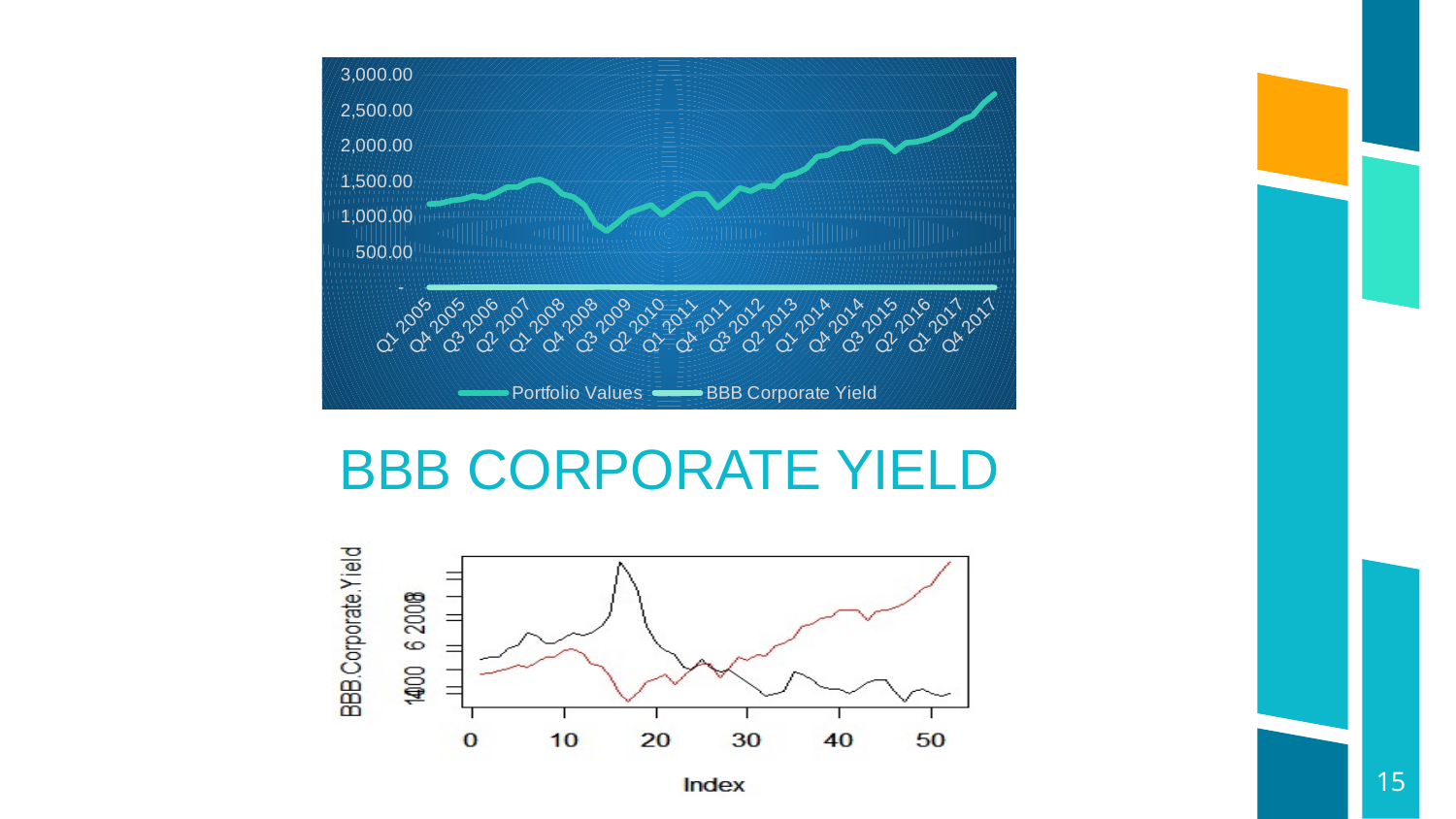
What kind of chart is the top chart on the slide? Line chart What is the x-axis title of the bottom chart? Index In the top chart, which series is higher across the whole period, Portfolio Values or BBB Corporate Yield? Portfolio Values What are the two series named in the legend of the top chart? Portfolio Values and BBB Corporate Yield In the top chart, does the Portfolio Values line overall rise or fall from Q1 2005 to Q4 2017? Rise In the top chart, is the lowest point of the Portfolio Values line greater or less than 1,000.00? less How many series does the legend of the top chart list? 2 In the top chart, how many quarter labels are shown on the x axis? 18 In the bottom chart, which line is higher at the right end of the x axis, the black line or the red line? The red line In the top chart, what is the first quarter label on the x axis? Q1 2005 In the top chart, is the Portfolio Values line at Q4 2017 greater or less than 2,000.00? greater In the top chart, is the Portfolio Values line at Q1 2005 greater or less than 1,500.00? less